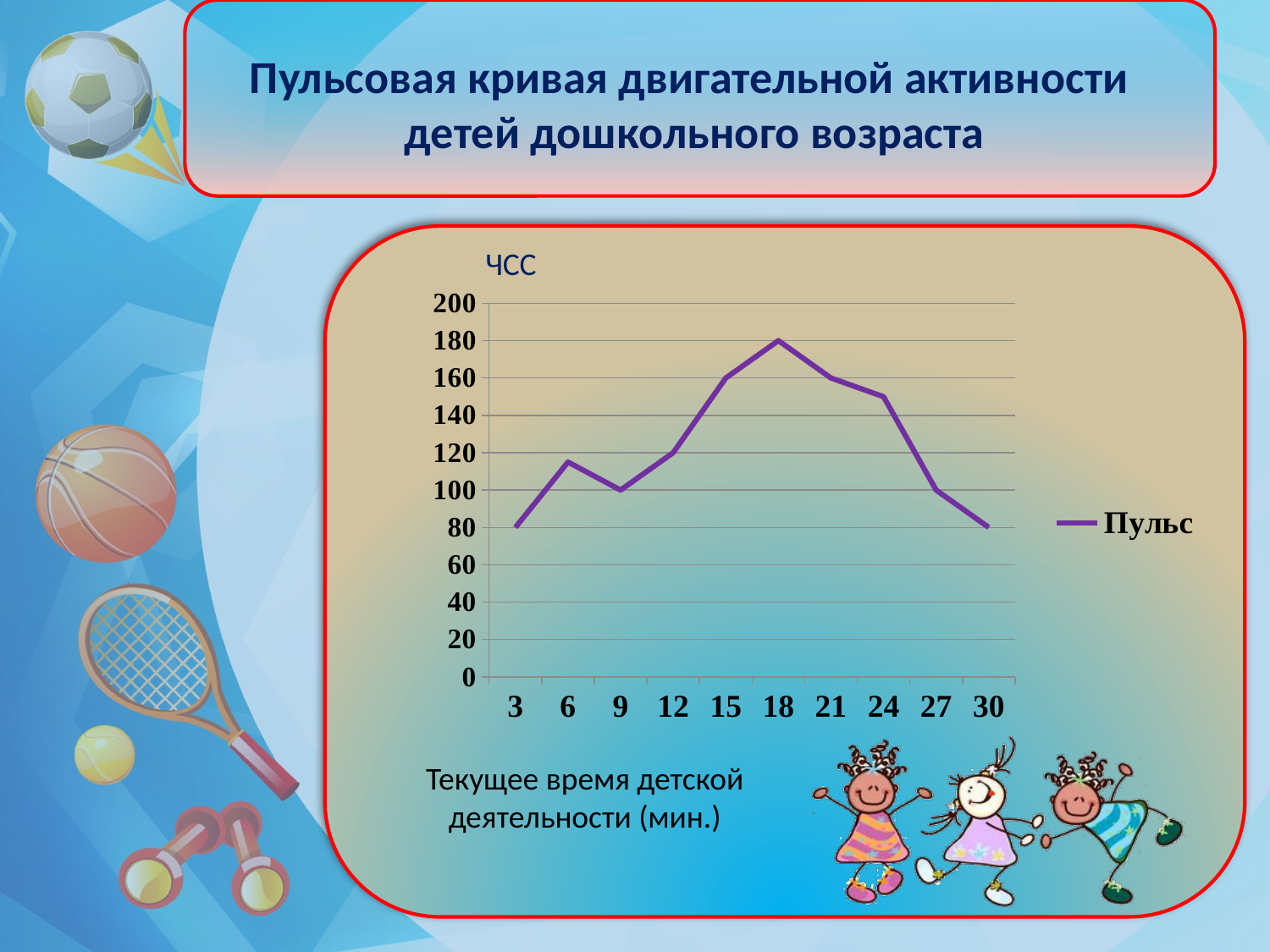
What is the name of the series shown in the legend? Пульс What is the pulse value at 3 minutes? 80 What is the pulse value at 18 minutes? 180 How many data points are plotted on the line? 10 What is the difference between the pulse at 18 minutes and the pulse at 3 minutes? 100 How many series does the legend list? 1 At which time (minutes) is the pulse highest? 18 What kind of chart is shown on the slide? line chart Is the pulse value at 24 minutes greater or less than 140? greater Is the pulse value at 6 minutes greater or less than 100? greater What is the pulse value at 15 minutes? 160 Which has a higher pulse value: 15 minutes or 27 minutes? 15 minutes